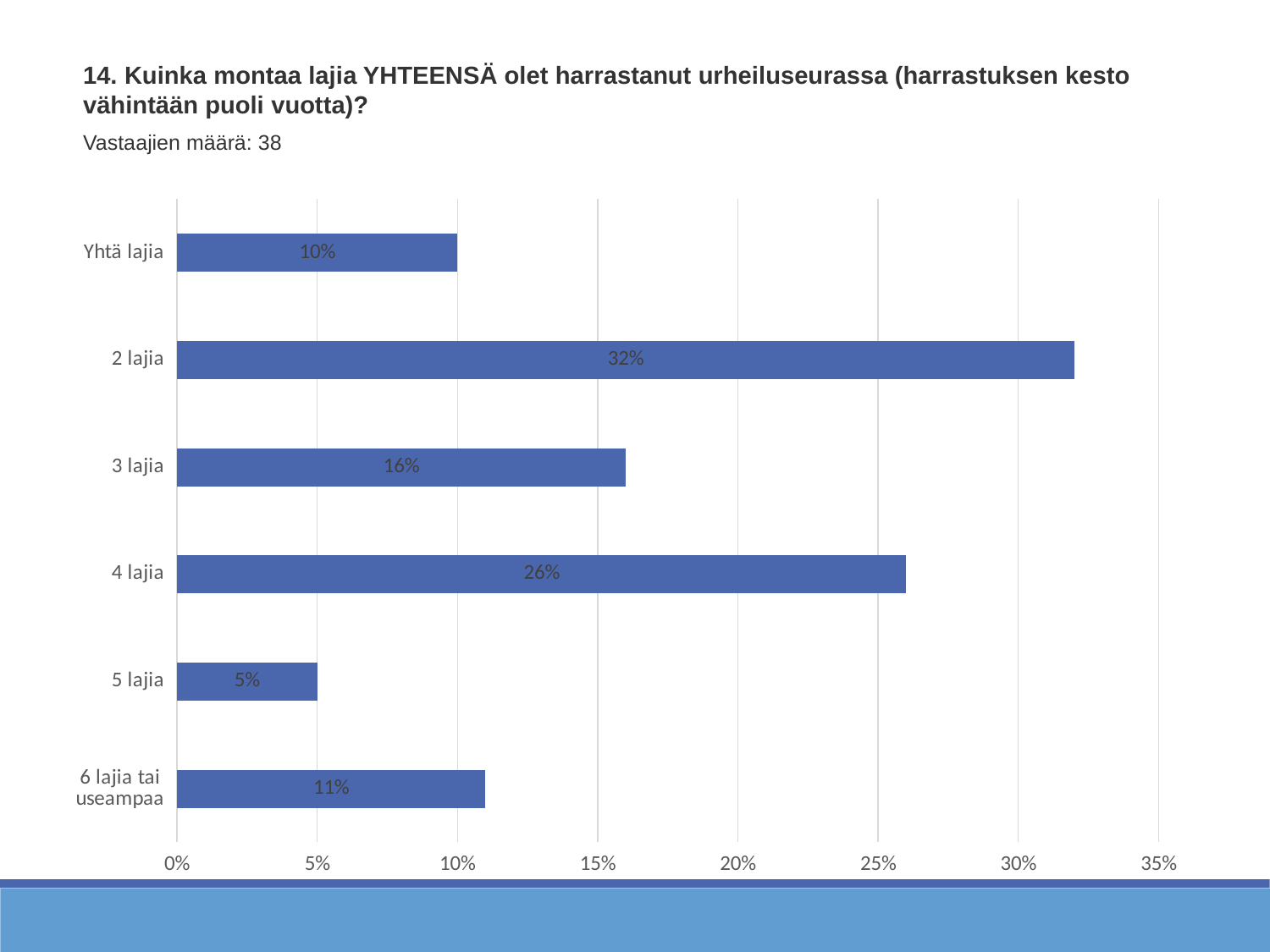
What is the value for "6 lajia tai useampaa"? 11% What kind of chart is shown on the slide? Bar chart What is the value for "4 lajia"? 26% Is the value for "4 lajia" greater or less than 25%? greater How many respondents (Vastaajien määrä) are stated on the slide? 38 What is the difference between the values for "2 lajia" and "3 lajia"? 16% What is the value for "2 lajia"? 32% What is the value for "Yhtä lajia"? 10% Which category has the highest value? 2 lajia Which category has the lowest value? 5 lajia Which is larger, the value for "4 lajia" or the value for "3 lajia"? 4 lajia How many categories are shown in the chart? 6